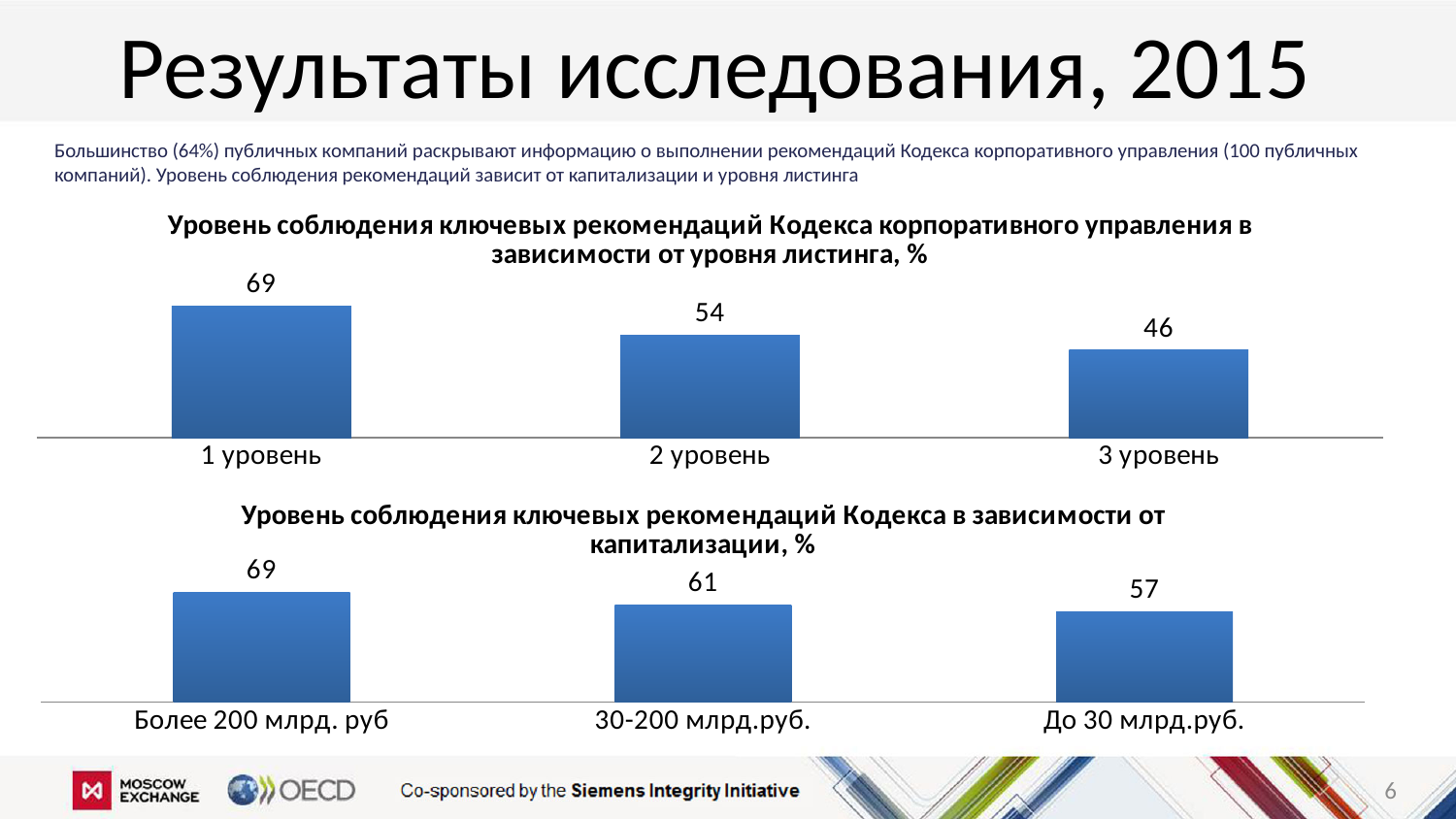
In the bottom chart (by capitalization), which category has the highest value? Более 200 млрд. руб In the top chart (by listing level), which category has the lowest value? 3 уровень In the top chart (by listing level), what is the value for 1 уровень? 69 In the bottom chart (by capitalization), what is the difference between Более 200 млрд. руб and До 30 млрд.руб.? 12 In the top chart (by listing level), what is the value for 3 уровень? 46 In the bottom chart (by capitalization), how many categories are shown? 3 In the top chart (by listing level), do the values rise or fall from 1 уровень to 3 уровень? fall In the top chart (by listing level), what is the difference between 1 уровень and 2 уровень? 15 What type of chart is the top chart (by listing level)? bar chart Which is larger: the value for 2 уровень in the top chart or the value for 30-200 млрд.руб. in the bottom chart? 30-200 млрд.руб. In the bottom chart (by capitalization), what is the value for 30-200 млрд.руб.? 61 In the bottom chart (by capitalization), what is the value for До 30 млрд.руб.? 57